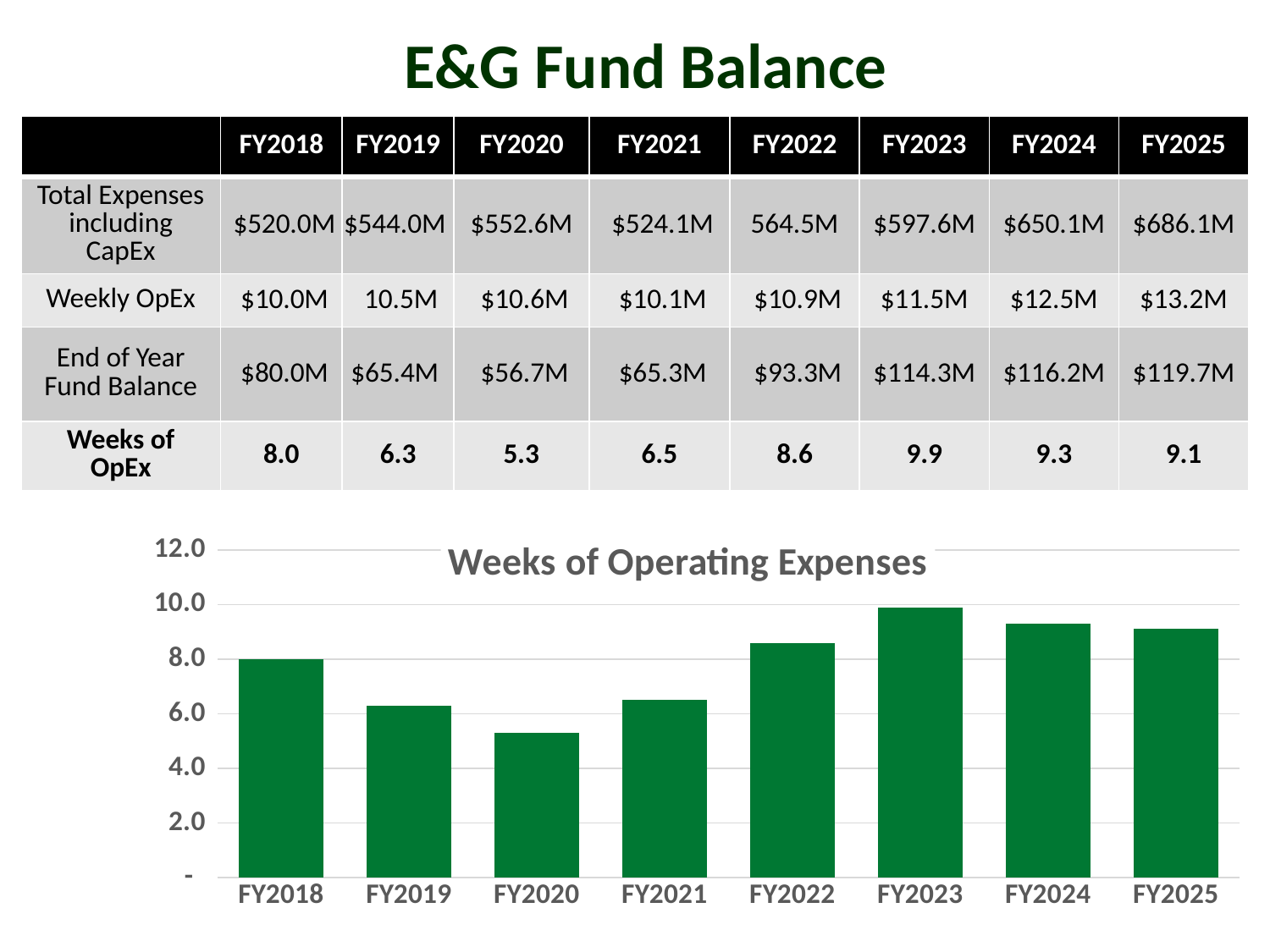
What kind of chart is shown on the slide? bar chart What is the title of the chart on the slide? Weeks of Operating Expenses How many fiscal years are plotted in the Weeks of Operating Expenses chart? 8 Is the value for FY2022 in the Weeks of Operating Expenses chart greater or less than 8.0? greater Which fiscal year has the lowest bar in the Weeks of Operating Expenses chart? FY2020 Which fiscal year has the highest bar in the Weeks of Operating Expenses chart? FY2023 What is the difference between the Weeks of OpEx values for FY2023 and FY2020? 4.6 What is the value for FY2023 in the Weeks of Operating Expenses chart? 9.9 Is the value for FY2020 in the Weeks of Operating Expenses chart greater or less than 6.0? less In the Weeks of Operating Expenses chart, which is larger, the bar for FY2018 or the bar for FY2022? FY2022 Do the bars rise or fall from FY2020 to FY2023 in the Weeks of Operating Expenses chart? rise What is the value for FY2018 in the Weeks of Operating Expenses chart? 8.0